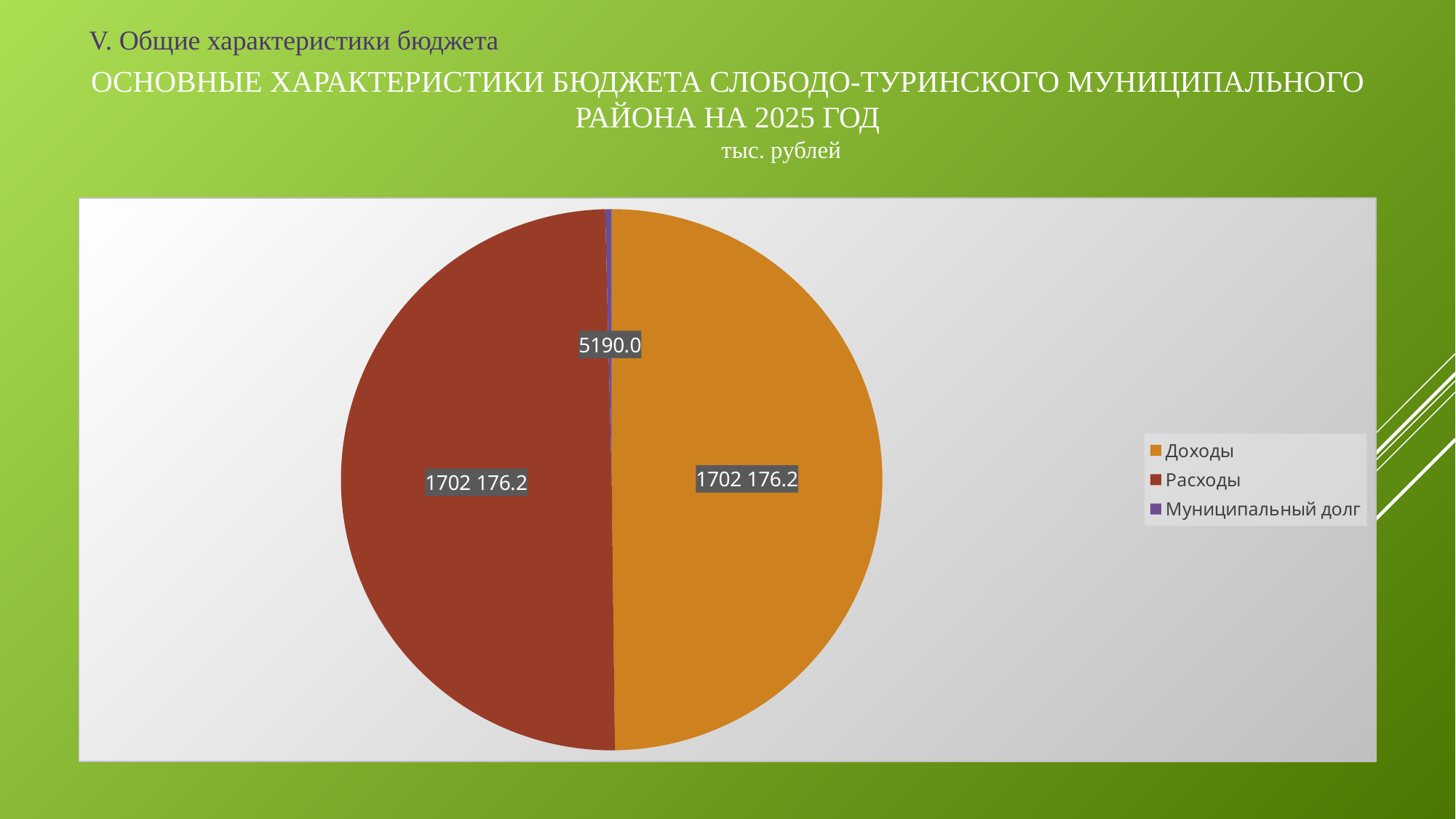
What unit is stated under the chart title? тыс. рублей What is the value for Муниципальный долг? 5190.0 Which is larger, Доходы or Муниципальный долг? Доходы What is the difference between the values for Расходы and Муниципальный долг? 1696 986.2 Which is larger, Доходы or Расходы? They are equal Which colour represents Расходы in the legend? Red-brown How many slices does the pie chart have? 3 Which category has the smallest slice of the pie? Муниципальный долг How many entries does the legend list? 3 What is the value for Доходы? 1702 176.2 What kind of chart is shown on the slide? pie chart What is the value for Расходы? 1702 176.2